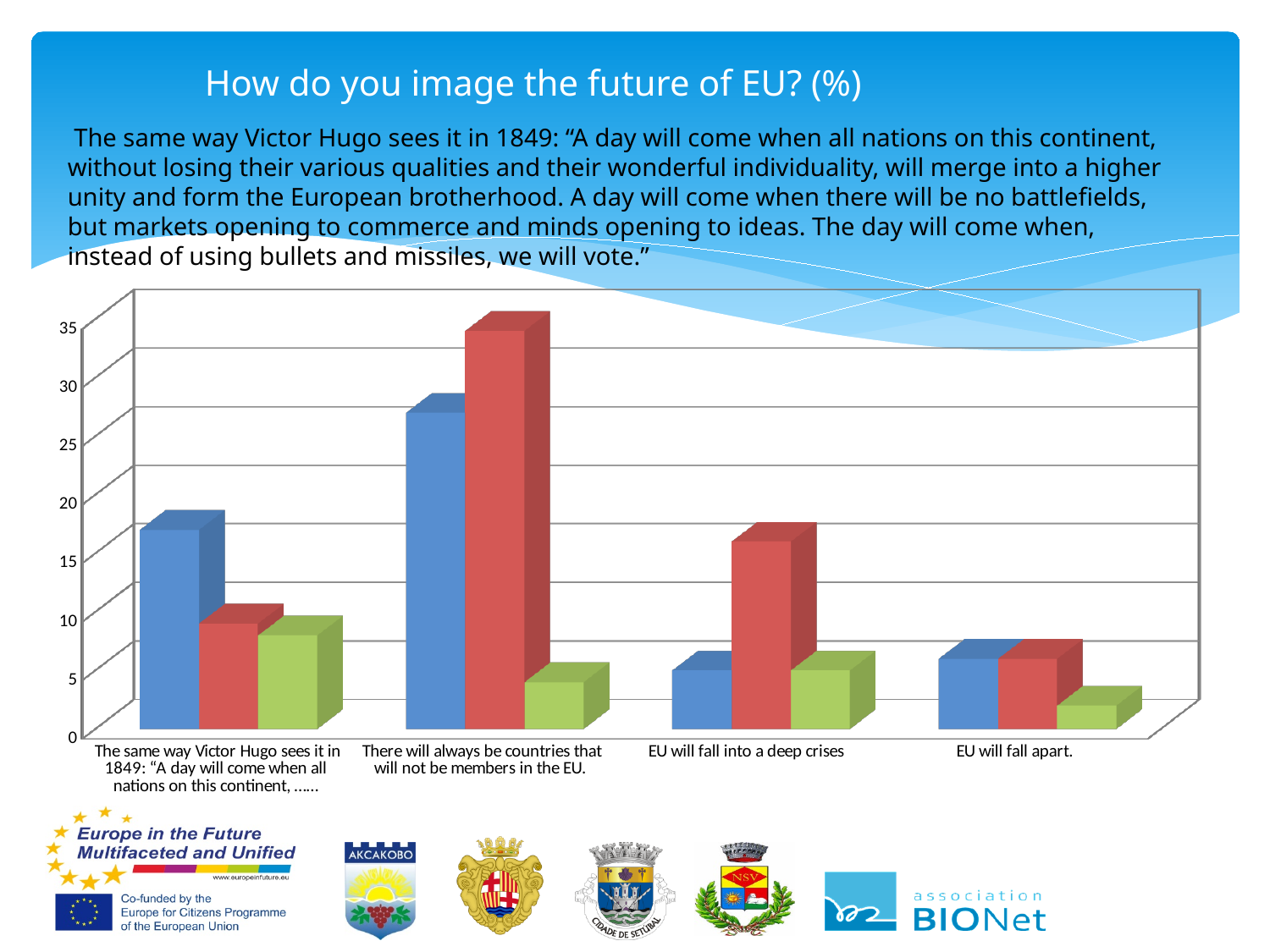
Is the value of the green bar for "EU will fall apart." greater or less than 5? less What kind of chart is shown on the slide? bar chart Is the value of the red bar for "EU will fall into a deep crises" greater or less than 10? greater Is the value of the green bar for "There will always be countries that will not be members in the EU." greater or less than 10? less For "EU will fall into a deep crises", which bar is taller, the red one or the green one? the red one Which category contains the tallest bar in the chart? There will always be countries that will not be members in the EU. For "There will always be countries that will not be members in the EU.", which bar is taller, the blue one or the red one? the red one What is the title of the chart on the slide? How do you image the future of EU? (%) How many categories are shown on the x axis of the chart? 4 How many bars are plotted for each category in the chart? 3